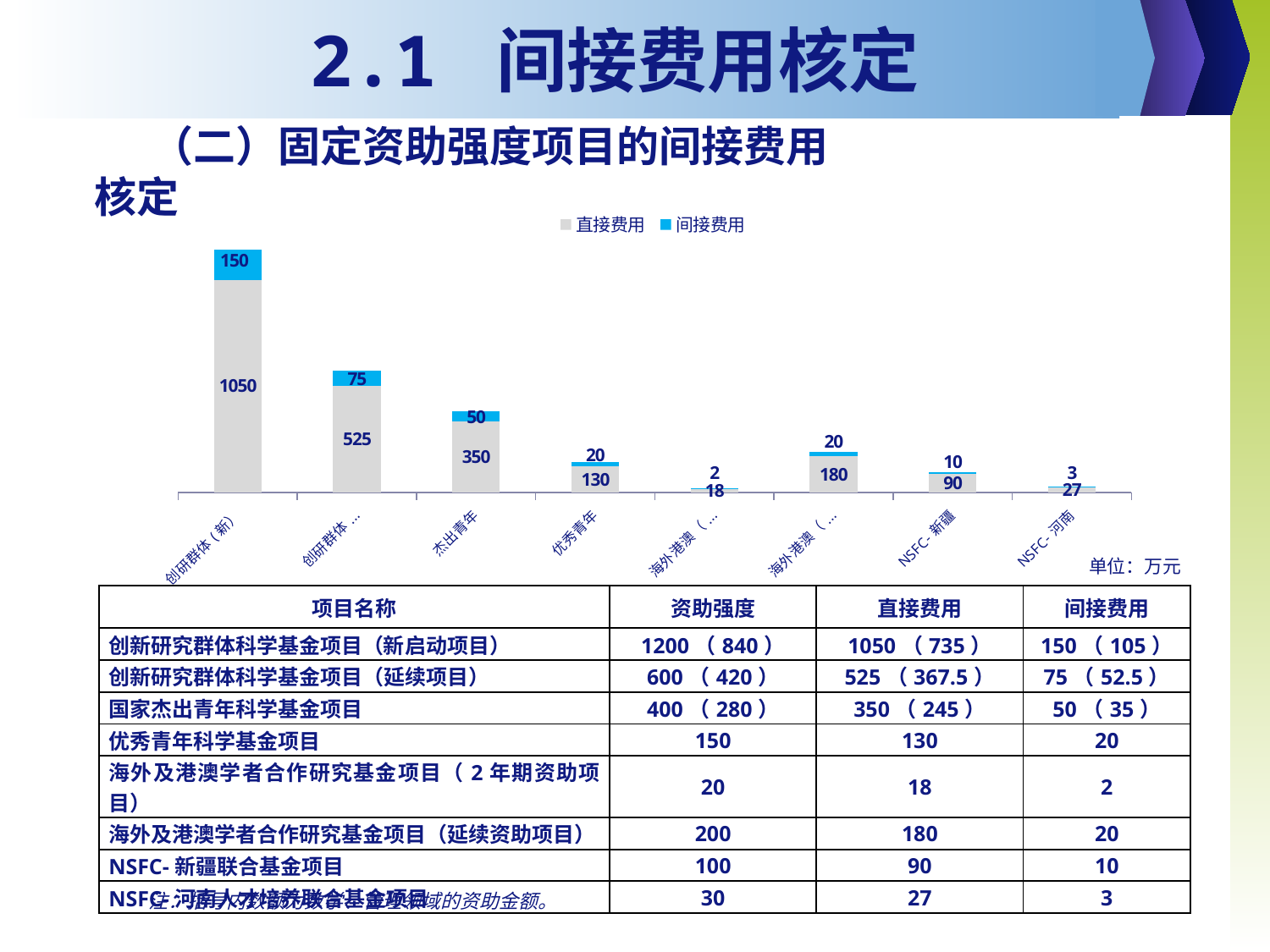
What is the 间接费用 value for NSFC-河南? 3 How many series does the chart legend list? 2 How many categories are plotted along the x axis of the chart? 8 What kind of chart is shown on the slide? Stacked bar chart What is the 直接费用 value for 创研群体（新）? 1050 Which series is shown in blue in the chart legend? 间接费用 Which category has the lowest 间接费用 value? 海外港澳（2年） What is the 间接费用 value for 杰出青年? 50 What is the 直接费用 value for NSFC-新疆? 90 What is the total of the stacked bar for 优秀青年? 150 What is the difference between the 直接费用 values for 杰出青年 and 优秀青年? 220 Which category has the highest 直接费用 value? 创研群体（新）